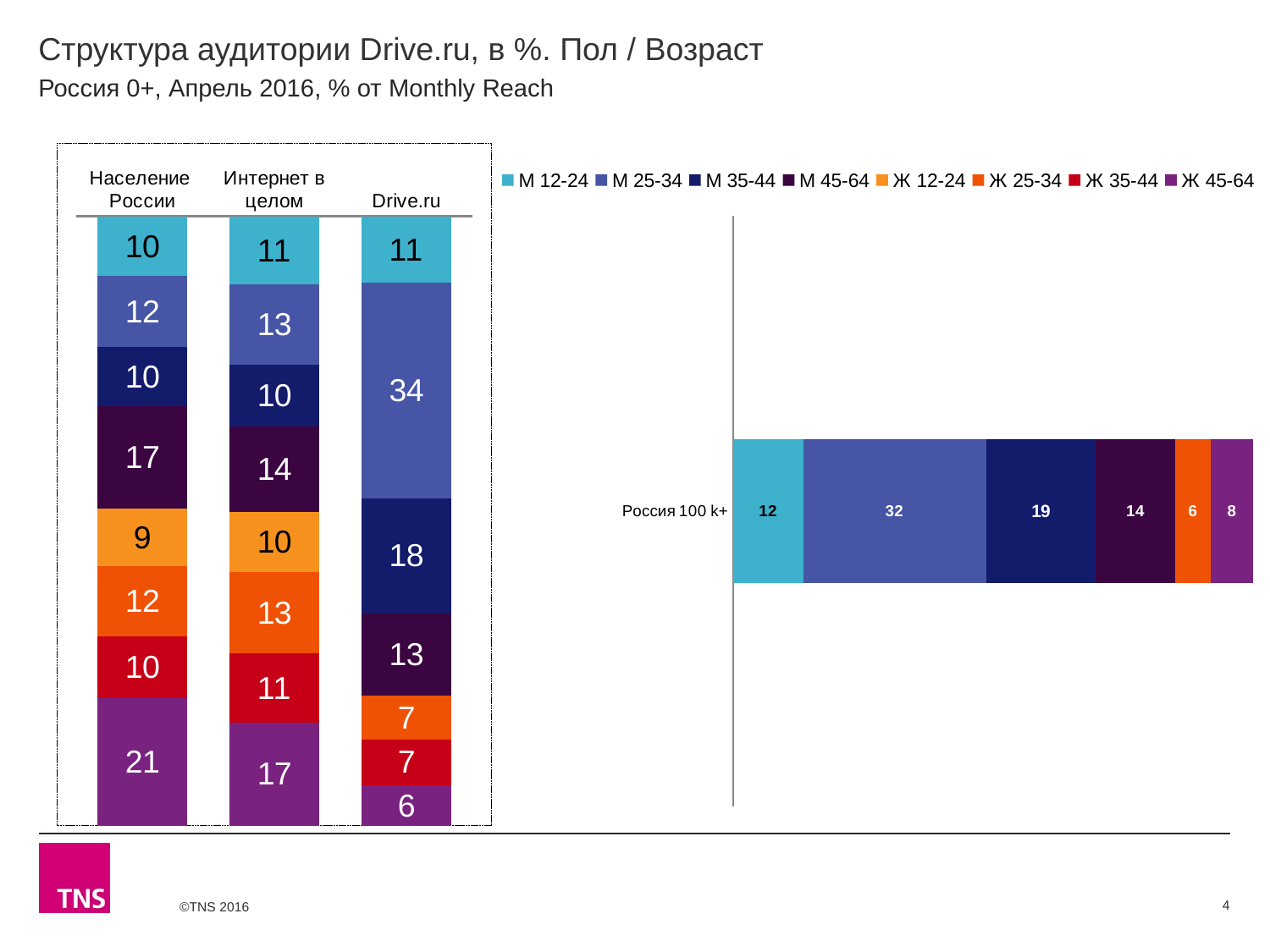
In the right chart, what is the value of the М 35-44 segment for Россия 100 k+? 19 In the left chart, what is the value of the М 45-64 segment for Интернет в целом? 14 In the left chart, what is the value of the Ж 45-64 segment for Население России? 21 How many series does the legend list? 8 In the left chart, which column has the smallest Ж 45-64 segment? Drive.ru In the left chart, what is the value of the М 25-34 segment for Drive.ru? 34 What type of chart is the right chart? Stacked bar chart In the left chart, which of the three columns has the largest М 25-34 segment? Drive.ru In the right chart, what is the value of the М 25-34 segment for Россия 100 k+? 32 In the left chart, what is the difference between the М 25-34 values for Drive.ru and Интернет в целом? 21 How many columns (categories) are shown in the left chart? 3 In the left chart, is the Ж 45-64 value for Население России larger or smaller than that for Интернет в целом? larger